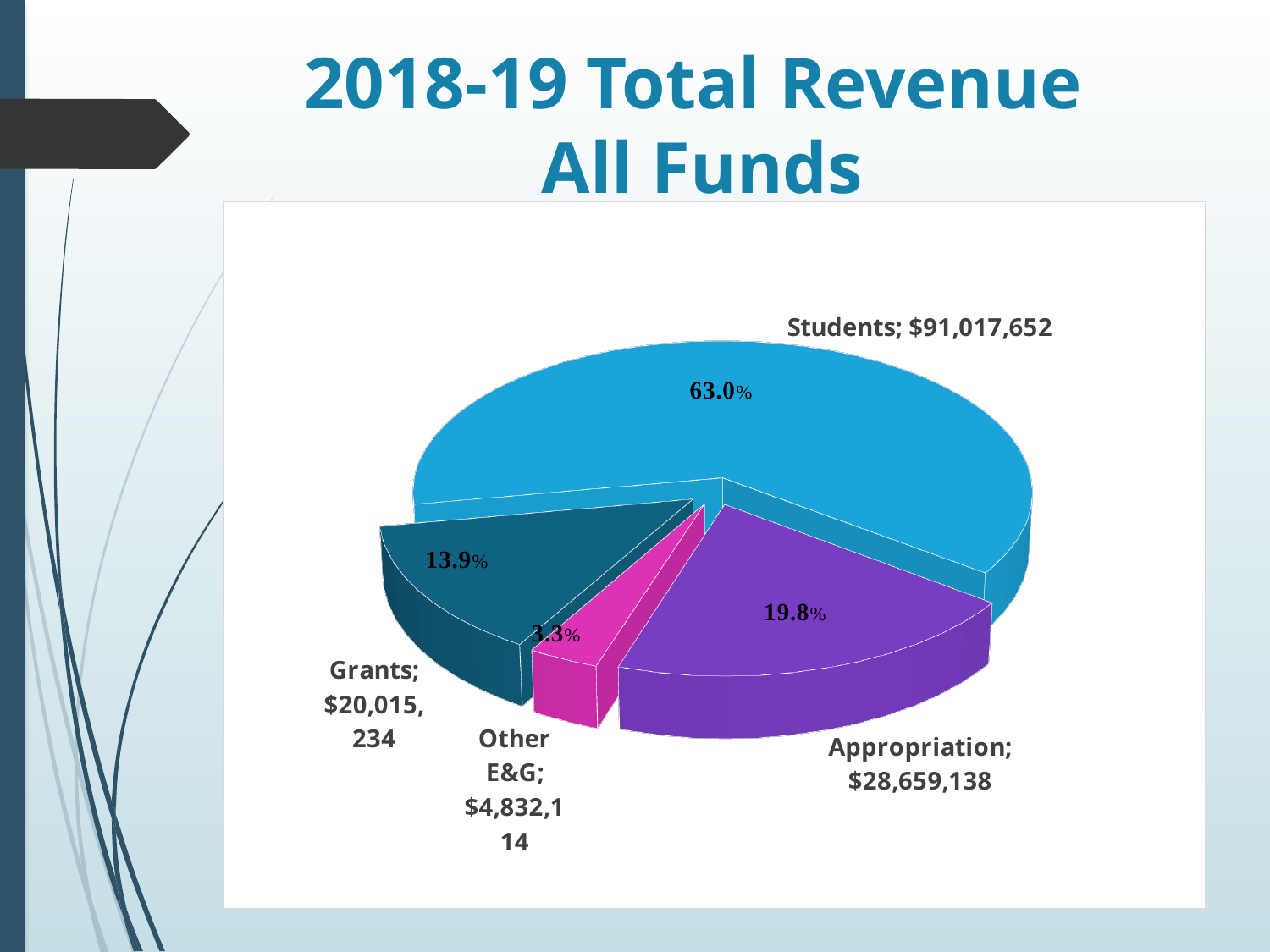
What is the revenue value for Appropriation? $28,659,138 Which is larger, Grants or Appropriation? Appropriation What is the revenue value for Grants? $20,015,234 What is the revenue value for Students? $91,017,652 Which revenue source is the smallest? Other E&G What is the revenue value for Other E&G? $4,832,114 What share of total revenue comes from Students? 63.0% What share of total revenue comes from Grants? 13.9% How many revenue categories are shown in the pie chart? 4 What kind of chart is shown on the slide? Pie chart Which revenue source is the largest? Students What share of total revenue comes from Appropriation? 19.8%